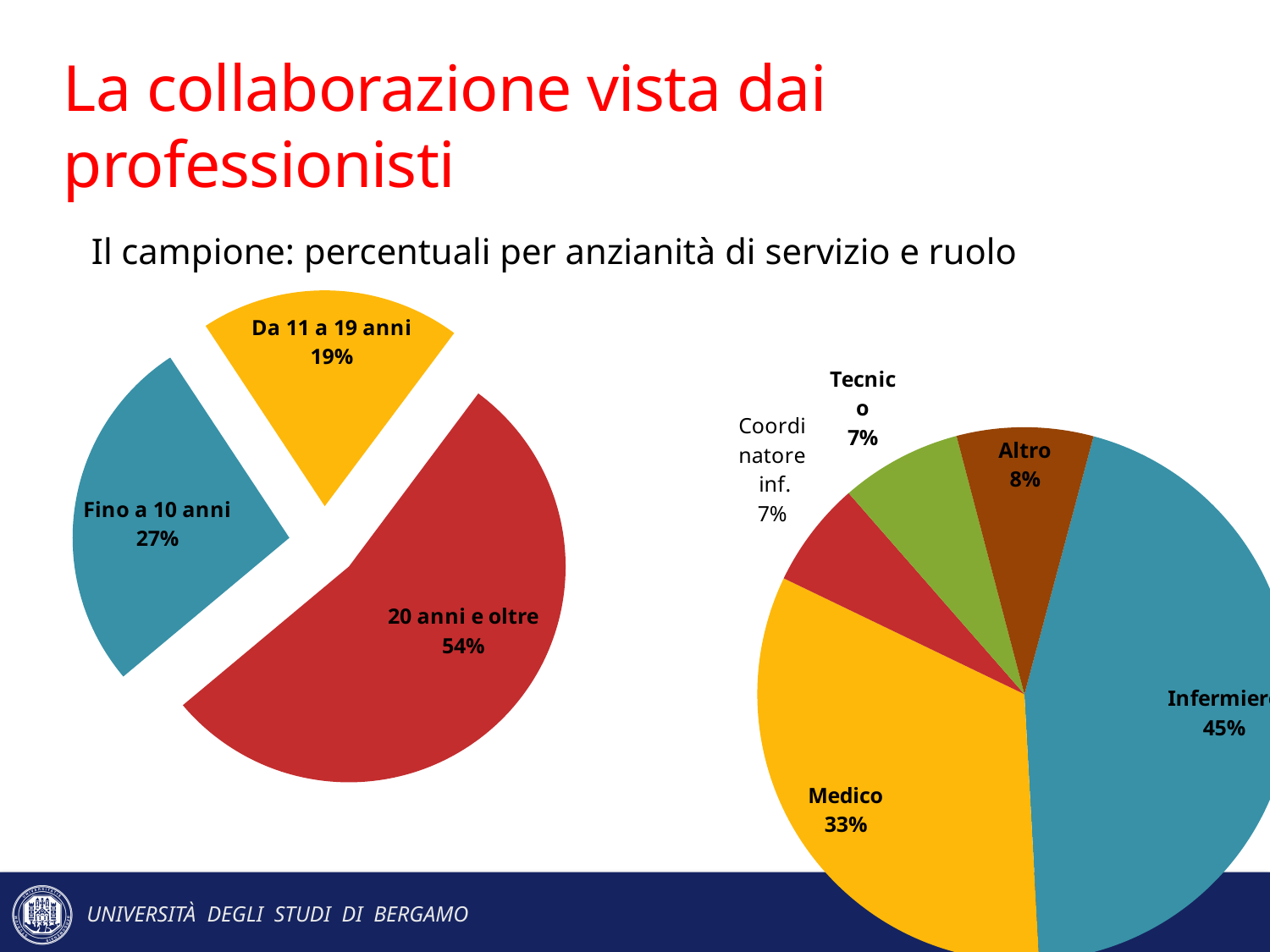
In the right pie chart, what percentage is shown for 'Altro'? 8% In the left pie chart, which category has the smallest share? Da 11 a 19 anni How many slices does the left pie chart have? 3 In the right pie chart, which category has the largest share? Infermiere In the right pie chart, what is the difference in percentage points between 'Infermiere' and 'Medico'? 12 In the left pie chart, what percentage is shown for 'Fino a 10 anni'? 27% In the right pie chart, which is larger, 'Medico' or 'Altro'? Medico In the left pie chart, what percentage is shown for '20 anni e oltre'? 54% In the left pie chart, what is the difference in percentage points between '20 anni e oltre' and 'Fino a 10 anni'? 27 What type of chart is the chart on the left of the slide? Pie chart In the right pie chart, what percentage is shown for 'Medico'? 33% How many slices does the right pie chart have? 5